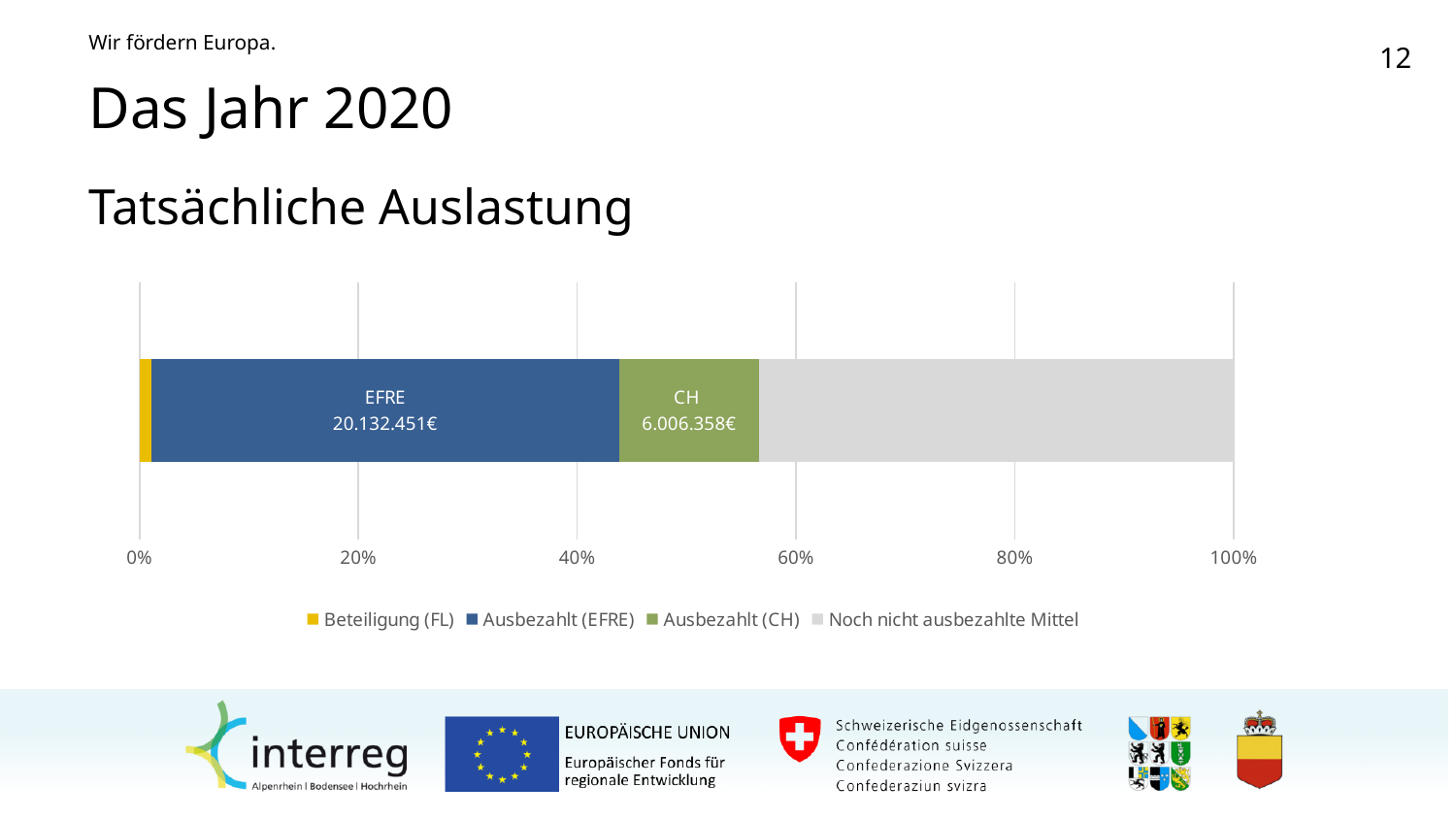
How many series does the legend list? 4 What value is printed on the EFRE segment of the bar? 20.132.451€ Which segment of the bar is the narrowest? Beteiligung (FL) What kind of chart is shown on the slide? Stacked bar chart What is the highest value shown on the horizontal axis? 100% Is the combined share of the paid-out segments (FL, EFRE and CH) greater or less than 50%? greater What is the difference between the EFRE amount and the CH amount? 14.126.093€ Which is larger, the EFRE amount or the CH amount? EFRE Is the share of 'Noch nicht ausbezahlte Mittel' greater or less than 60%? less What value is printed on the CH segment of the bar? 6.006.358€ Which legend entry is shown in grey? Noch nicht ausbezahlte Mittel